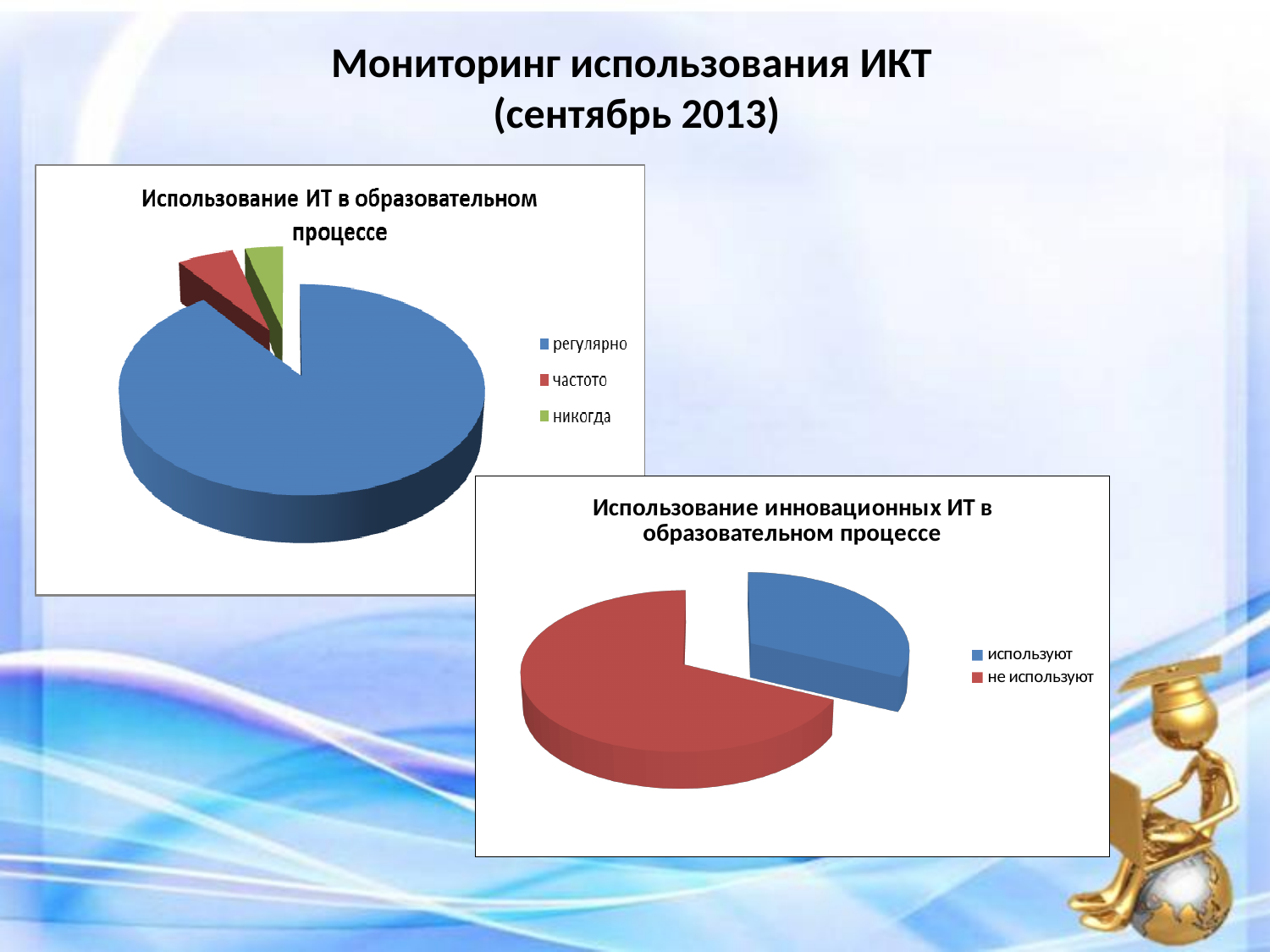
In the chart "Использование инновационных ИТ в образовательном процессе", which category has the largest slice? не используют In the chart "Использование инновационных ИТ в образовательном процессе", which slice is larger: используют or не используют? не используют In the chart "Использование инновационных ИТ в образовательном процессе", what colour is the slice for используют? blue What kind of chart is the chart titled "Использование ИТ в образовательном процессе"? pie chart In the chart "Использование ИТ в образовательном процессе", which category has the smallest slice? никогда What kind of chart is the chart titled "Использование инновационных ИТ в образовательном процессе"? pie chart In the chart "Использование ИТ в образовательном процессе", which category has the largest slice? регулярно In the chart "Использование ИТ в образовательном процессе", which slice is larger: частото or никогда? частото In the chart "Использование ИТ в образовательном процессе", what colour is the slice for никогда? green In the chart "Использование ИТ в образовательном процессе", how many categories does the legend list? 3 In the chart "Использование инновационных ИТ в образовательном процессе", how many categories does the legend list? 2